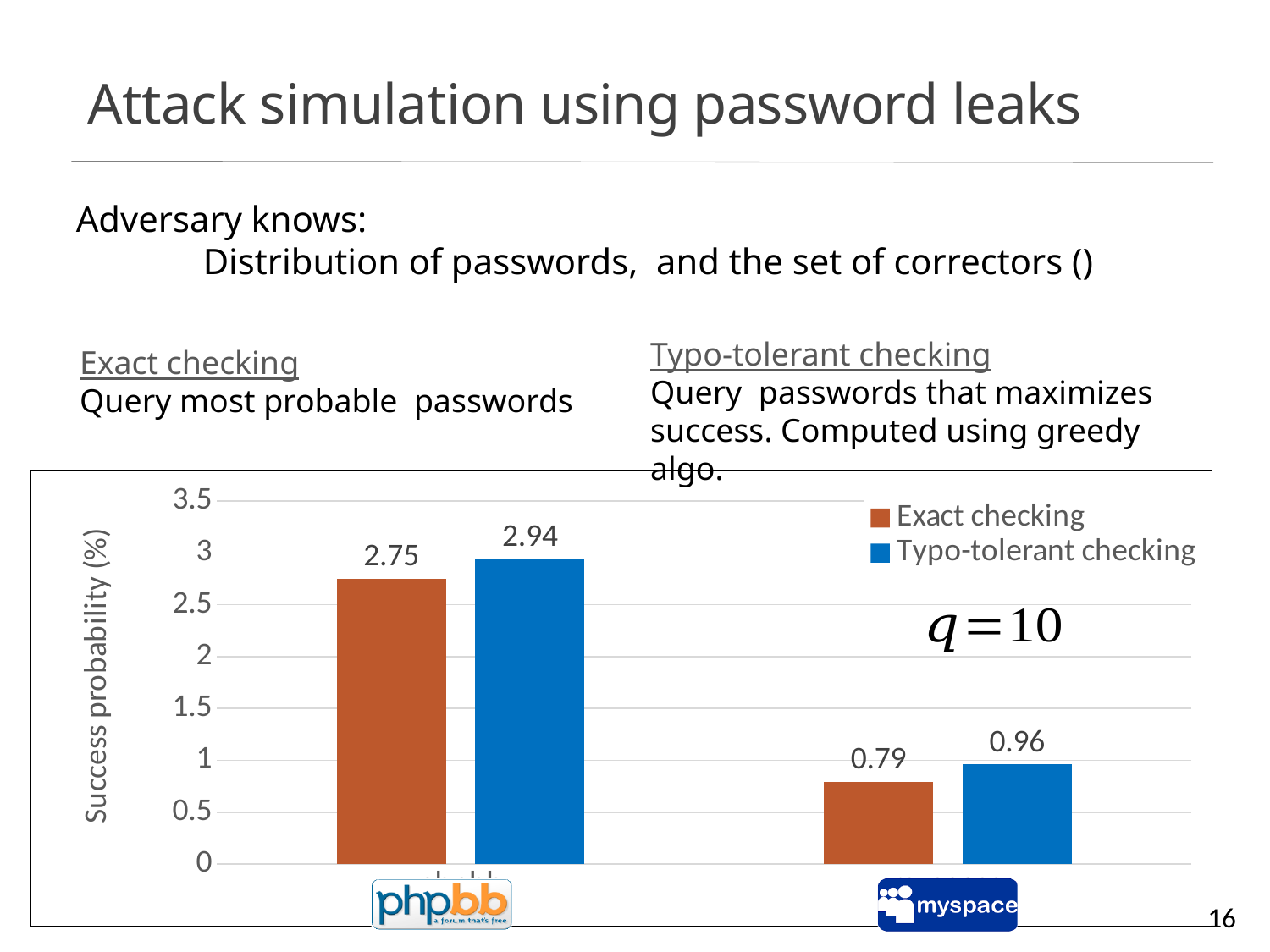
Which is larger for myspace: Exact checking or Typo-tolerant checking? Typo-tolerant checking What is the label of the y axis? Success probability (%) What is the success probability for Typo-tolerant checking on phpBB? 2.94 Which bar has the highest success probability in the chart? Typo-tolerant checking on phpBB What is the success probability for Typo-tolerant checking on myspace? 0.96 What is the difference between Typo-tolerant checking and Exact checking for phpBB? 0.19 Which bar has the lowest success probability in the chart? Exact checking on myspace What is the success probability for Exact checking on phpBB? 2.75 How many series does the legend list? 2 What is the difference between Typo-tolerant checking and Exact checking for myspace? 0.17 What kind of chart is shown on the slide? Bar chart What is the success probability for Exact checking on myspace? 0.79